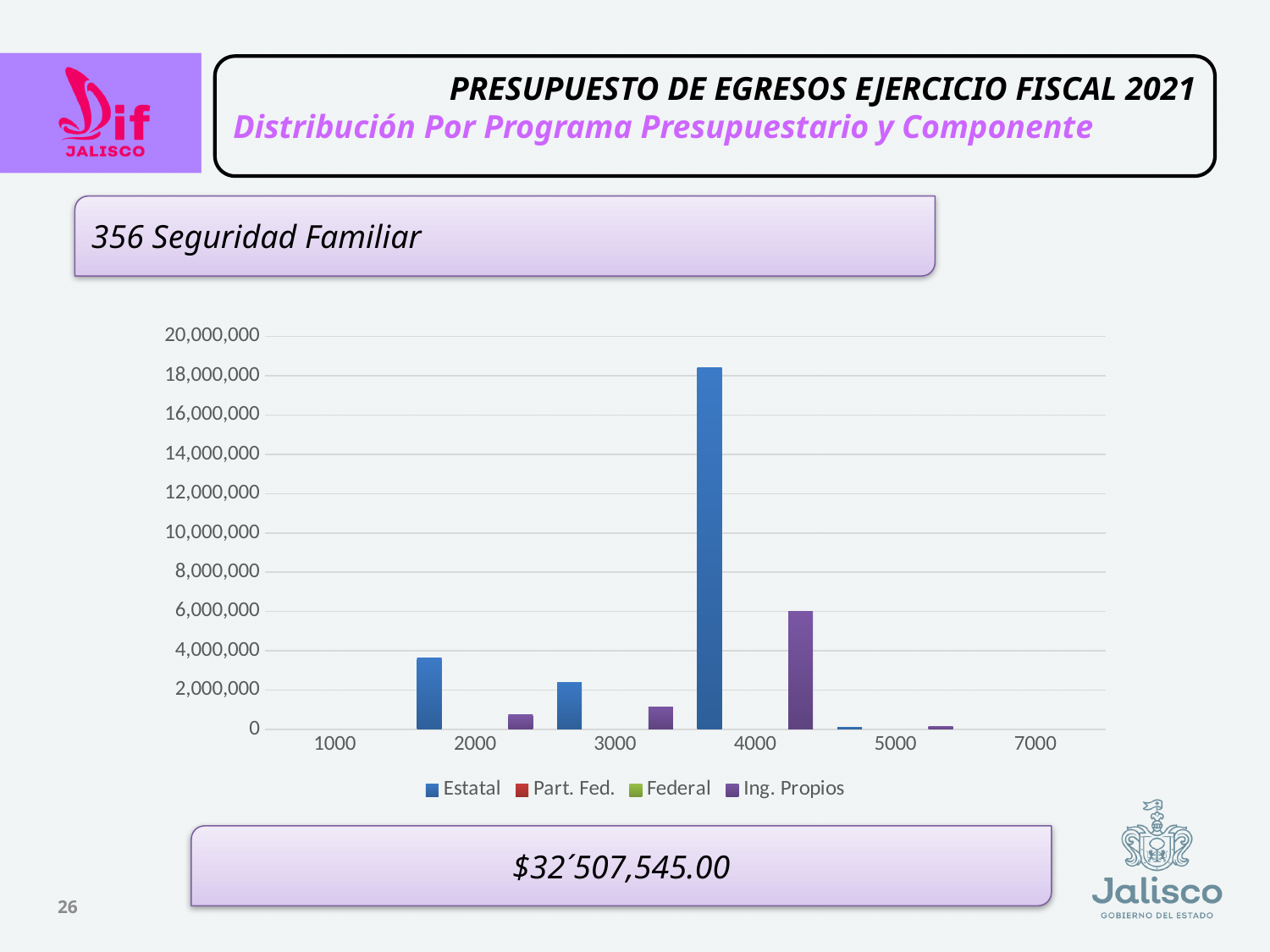
For category 4000, which series has the larger value, Estatal or Ing. Propios? Estatal How many categories are shown on the x axis of the chart? 6 Is the Estatal value for category 2000 greater or less than 4,000,000? less Is the Estatal value for category 4000 greater or less than 16,000,000? greater Is the Ing. Propios value for category 3000 greater or less than 2,000,000? less What is the name of the program shown above the chart? 356 Seguridad Familiar How many series does the chart legend list? 4 What kind of chart is shown on the slide? bar chart Which category has the highest Estatal bar? 4000 Which category has the larger Estatal value, 2000 or 3000? 2000